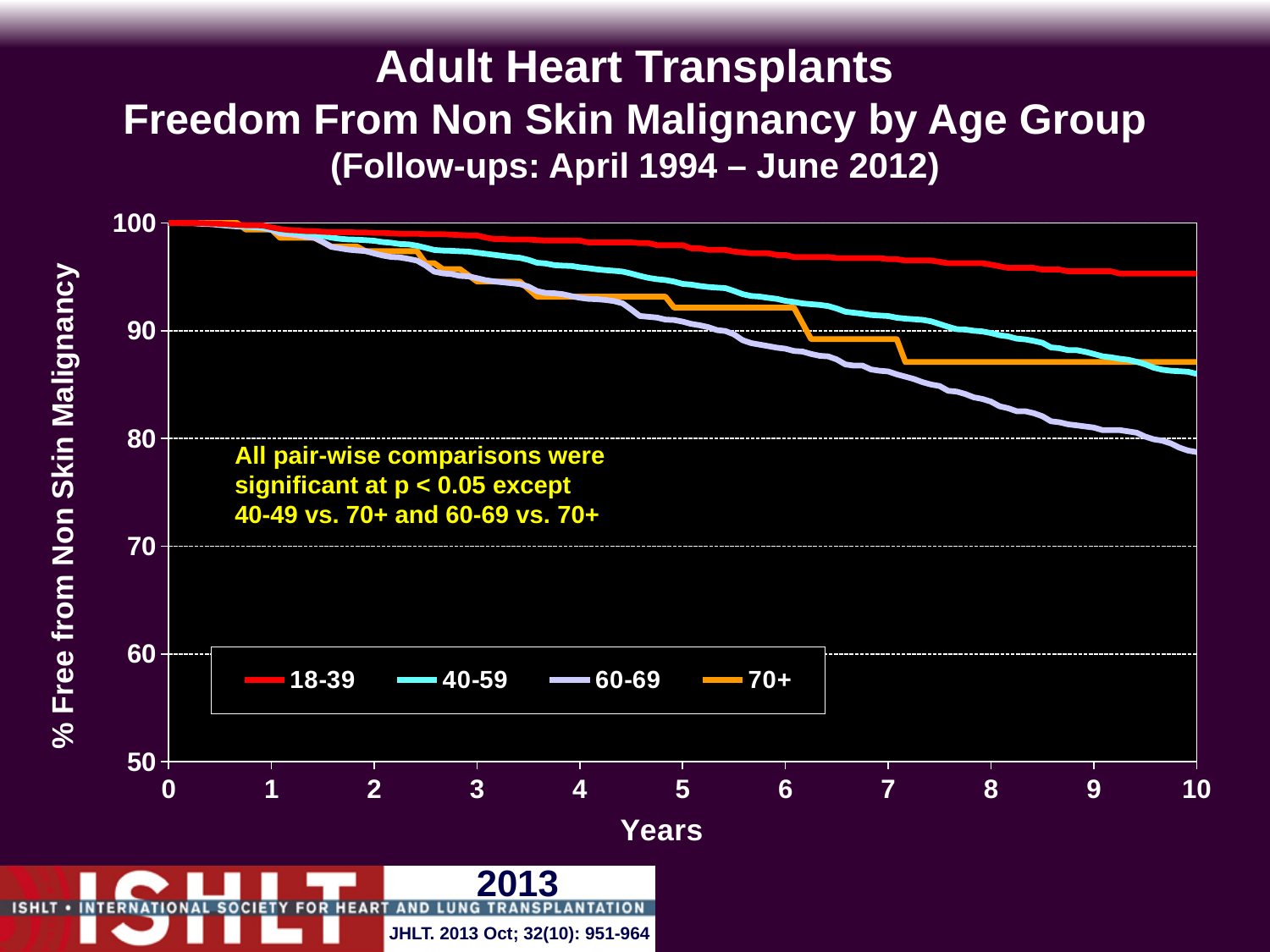
Is the value for the 60-69 age group at 10 years greater or less than 80? less How many age groups does the legend list? 4 At 10 years, which is larger: the value for the 18-39 age group or the 60-69 age group? 18-39 Is the value for the 40-59 age group at 10 years greater or less than 90? less Which age group has the lowest % free from non skin malignancy at 10 years? 60-69 Which age groups are listed in the legend? 18-39, 40-59, 60-69, 70+ What is the label of the y axis? % Free from Non Skin Malignancy Do the values for the 60-69 age group rise or fall as years increase? fall At 8 years, which is larger: the value for the 70+ age group or the 60-69 age group? 70+ Which age group has the highest % free from non skin malignancy at 10 years? 18-39 Is the value for the 18-39 age group at 10 years greater or less than 90? greater What kind of chart is shown on the slide? line chart